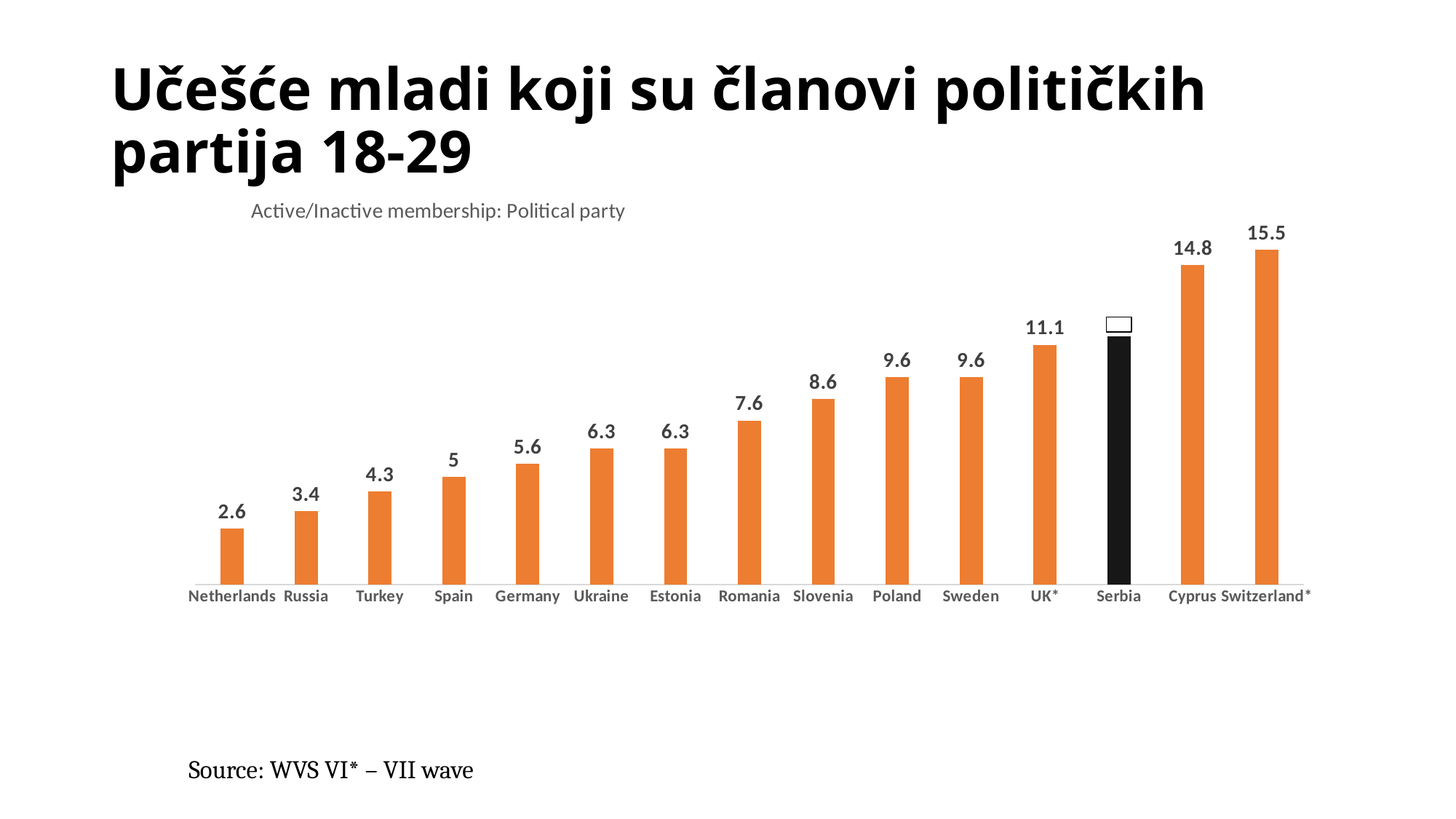
What is the value for UK*? 11.1 What is the value for Netherlands? 2.6 What is the difference between the values for Switzerland* and Netherlands? 12.9 Which country has the highest value? Switzerland* What is the value for Germany? 5.6 Which is larger, the value for Spain or the value for Turkey? Spain What kind of chart is shown on the slide? Bar chart What is the value for Cyprus? 14.8 What is the difference between the values for Slovenia and Romania? 1 How many countries are shown in the chart? 15 Which country's bar is coloured black instead of orange? Serbia Which country has the lowest value? Netherlands